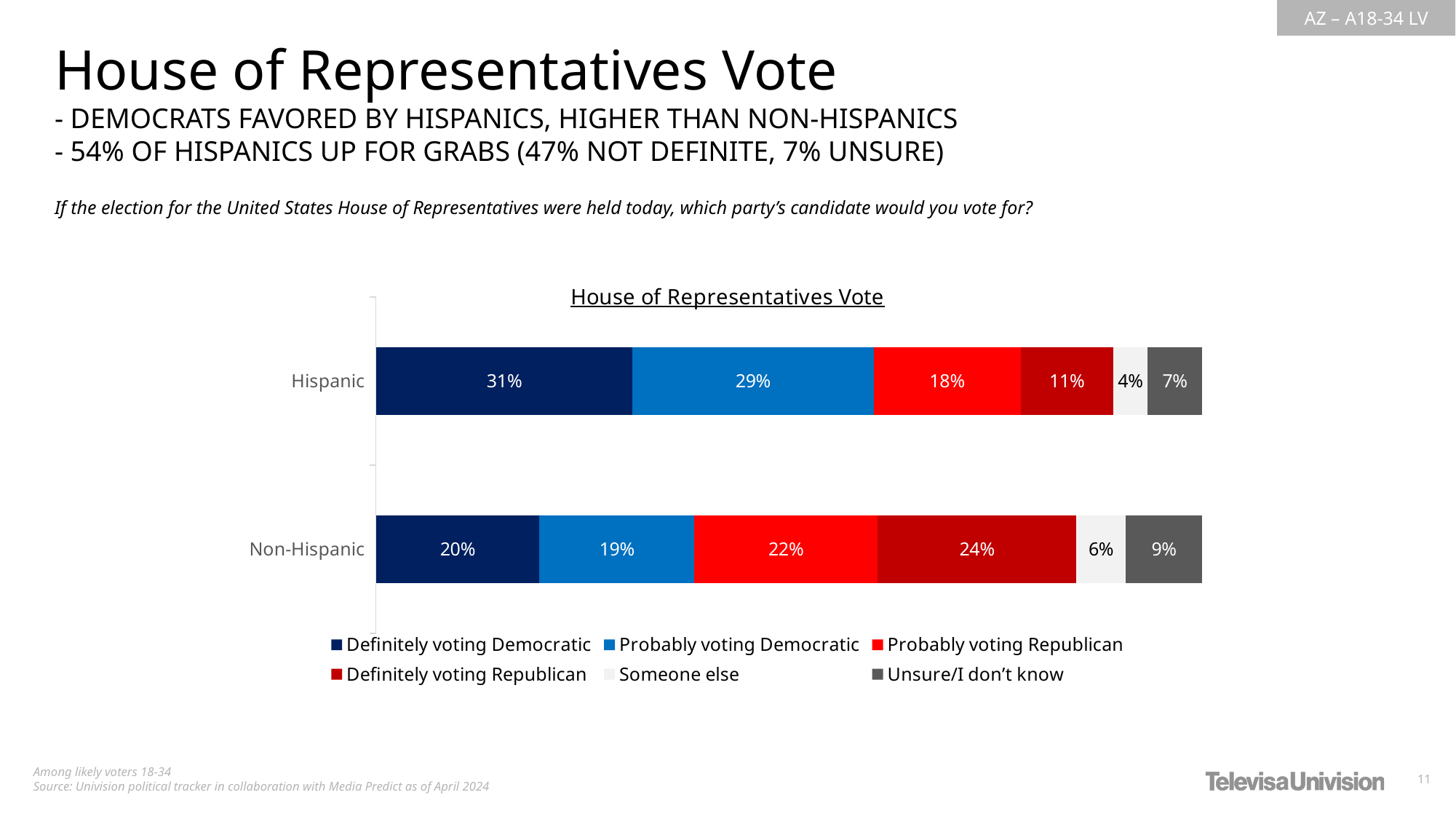
What is the difference between the Hispanic and Non-Hispanic shares for definitely voting Republican? 13% What type of chart is shown on the slide? Stacked bar chart What percentage of Hispanic respondents answered Unsure/I don't know? 7% What percentage of Non-Hispanic respondents are definitely voting Republican? 24% How many groups (categories) are shown on the chart? 2 Which response category is the largest for the Hispanic bar? Definitely voting Democratic What is the difference between the Hispanic and Non-Hispanic shares for definitely voting Democratic? 11% What percentage of Non-Hispanic respondents chose Someone else? 6% Which response category is the smallest for the Non-Hispanic bar? Someone else How many series does the legend list? 6 What percentage of Hispanic respondents are definitely voting Democratic? 31% Which group has the higher share of respondents probably voting Democratic, Hispanic or Non-Hispanic? Hispanic